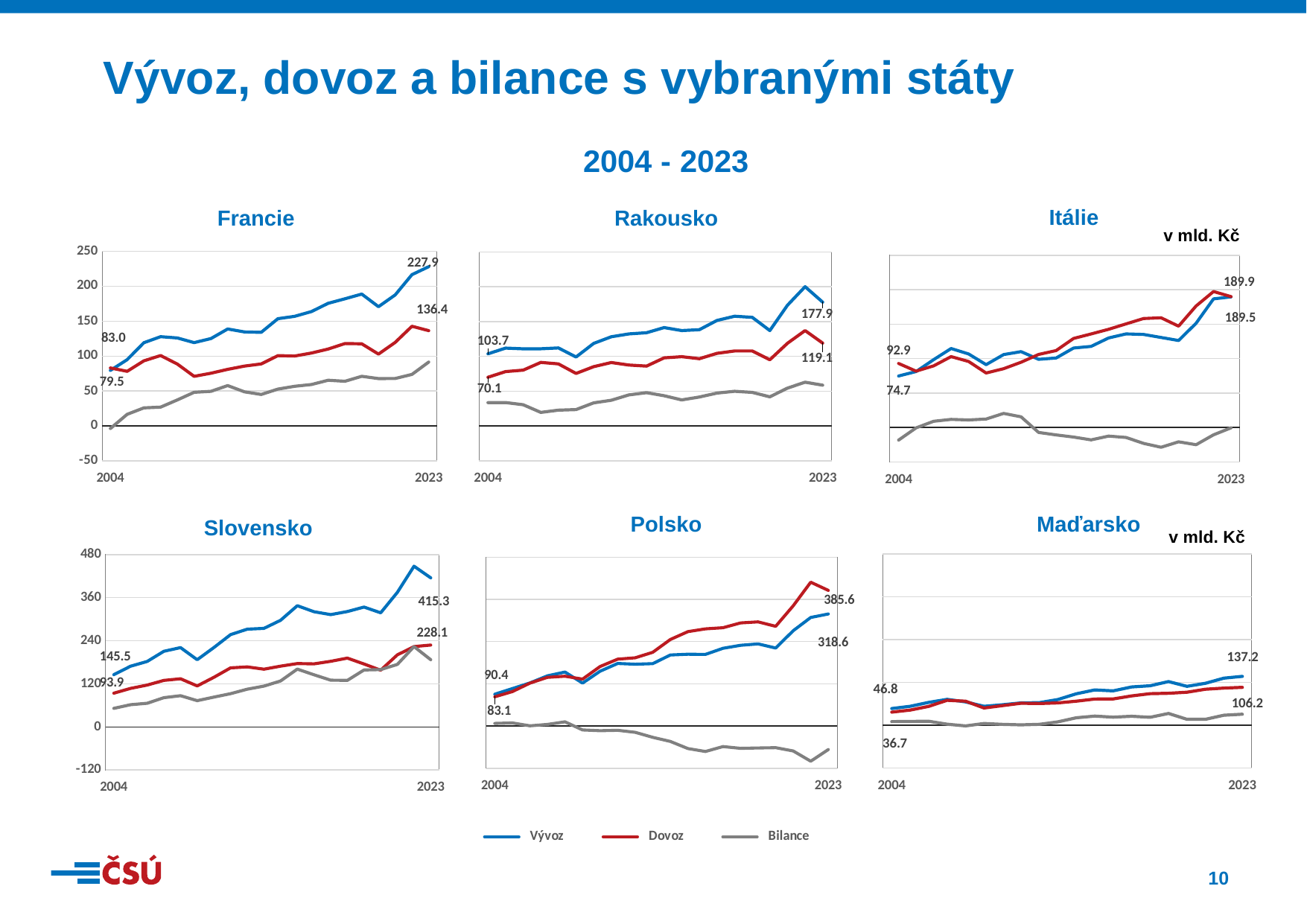
In the Francie chart, what is the difference between Vývoz and Dovoz in 2023? 91.5 In the Rakousko chart, what is the value of Dovoz in 2023? 119.1 In the Slovensko chart, what is the value of Vývoz in 2023? 415.3 In the Francie chart, what is the value of Vývoz in 2023? 227.9 In the Rakousko chart, what is the value of Vývoz in 2004? 103.7 In the Francie chart, what is the value of Dovoz in 2004? 83.0 In the Polsko chart, which is larger in 2023, Vývoz or Dovoz? Dovoz How many series does the legend list? 3 What kind of chart is the Slovensko chart? Line chart In the Maďarsko chart, what is the value of Vývoz in 2023? 137.2 In the Francie chart, does the Vývoz line generally rise or fall from 2004 to 2023? Rise In the Polsko chart, what is the value of Dovoz in 2023? 385.6